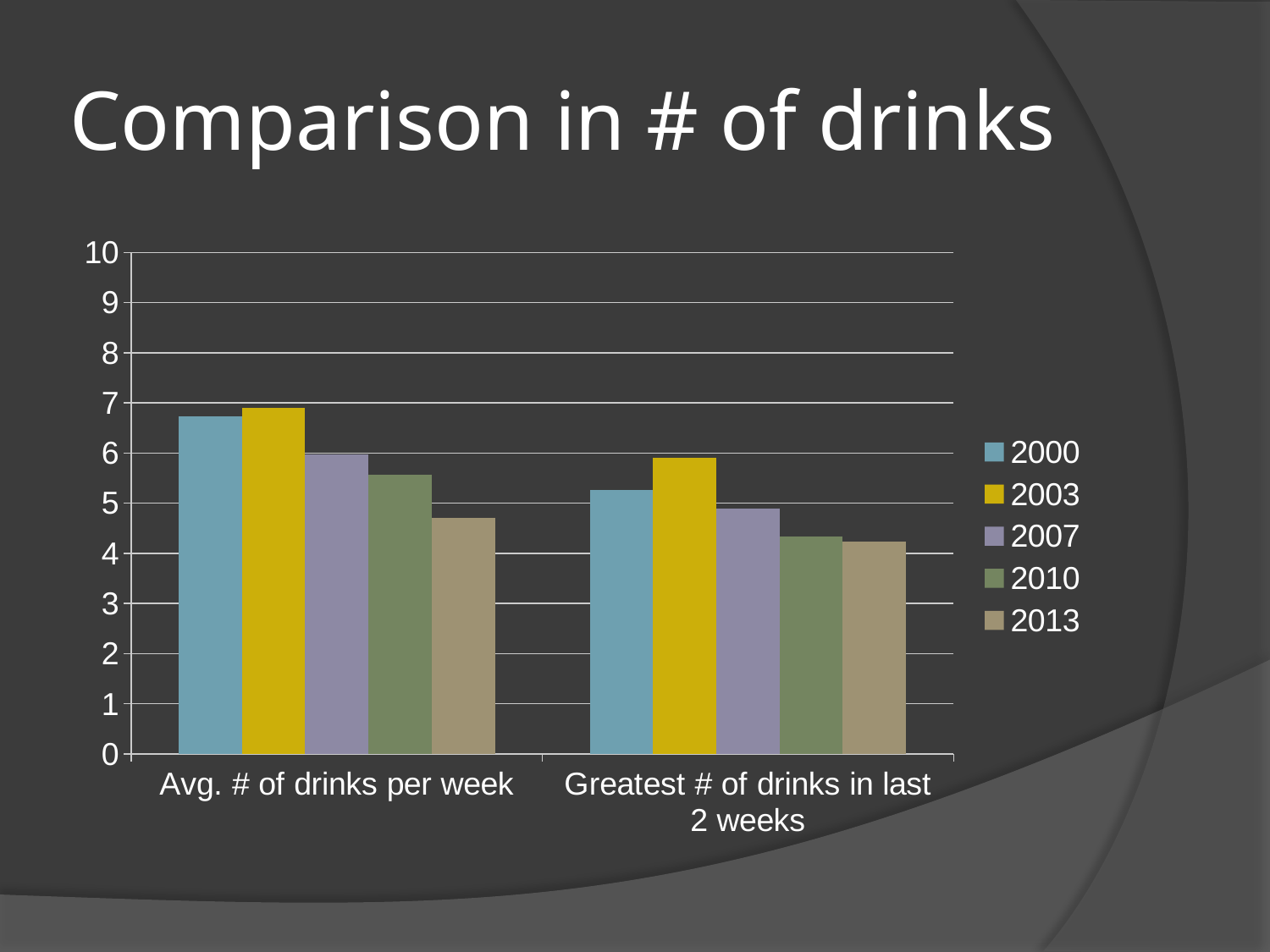
How many categories are shown on the x axis? 2 Is the value for 2000 in "Avg. # of drinks per week" greater or less than 6? greater Does the value for 2000 rise or fall from "Avg. # of drinks per week" to "Greatest # of drinks in last 2 weeks"? fall Is the value for 2010 in "Greatest # of drinks in last 2 weeks" greater or less than 5? less What kind of chart is shown on the slide? bar chart Which year has the lowest value for "Avg. # of drinks per week"? 2013 Is the value for 2013 in "Avg. # of drinks per week" greater or less than 5? less Which year has the highest value for "Greatest # of drinks in last 2 weeks"? 2003 For "Greatest # of drinks in last 2 weeks", which is larger, the value for 2003 or the value for 2010? 2003 For "Avg. # of drinks per week", which is larger, the value for 2000 or the value for 2007? 2000 How many series does the legend list? 5 What is the title of the slide containing the chart? Comparison in # of drinks